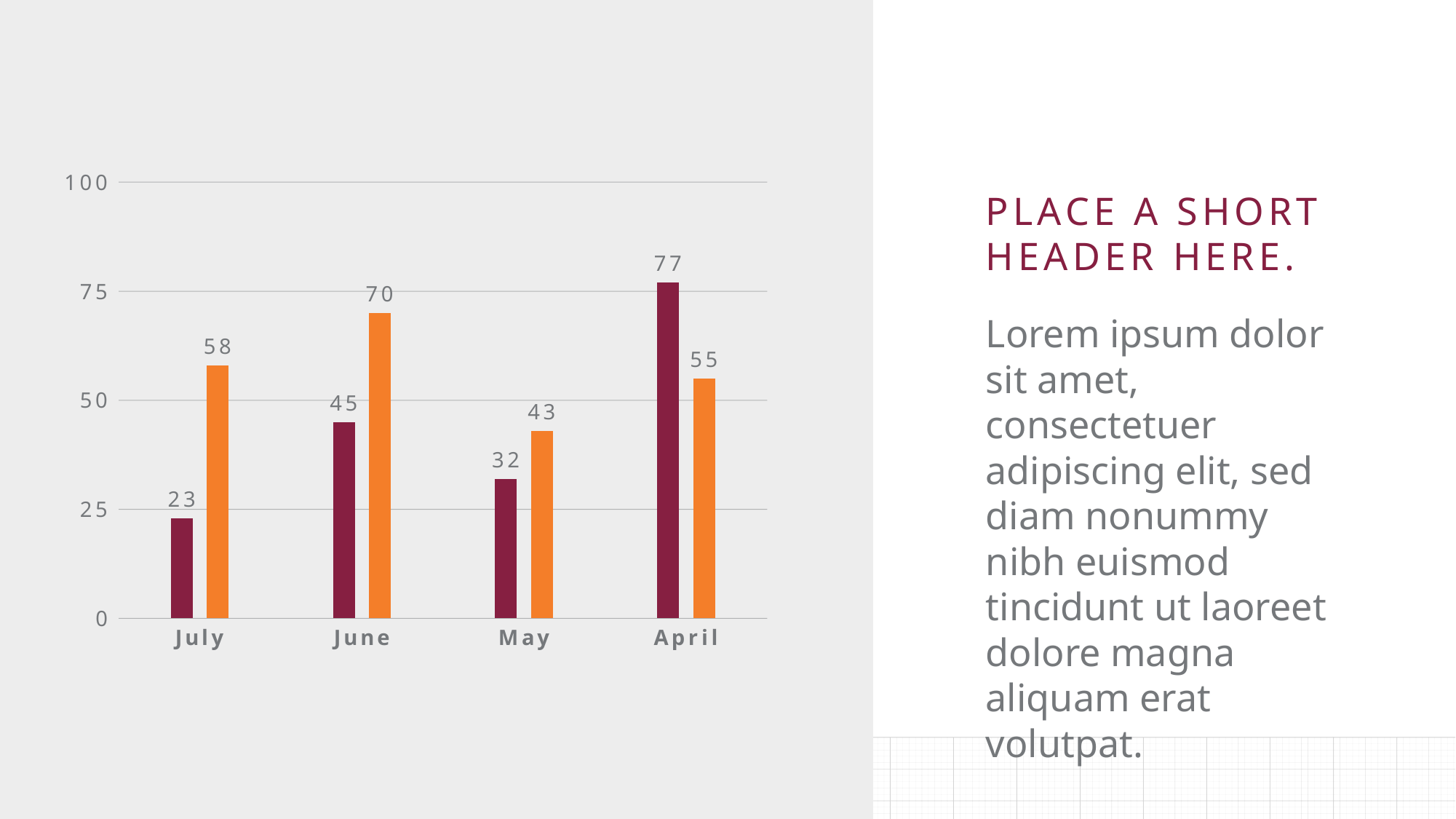
Which category has the highest dark red bar? April What is the value of the dark red bar for May? 32 What is the value of the orange bar for June? 70 What is the value of the dark red bar for July? 23 What kind of chart is shown on the slide? bar chart What is the highest value shown on the y axis? 100 How many categories are shown on the x axis? 4 Which is larger for April, the dark red bar or the orange bar? the dark red bar What is the difference between the orange bar and the dark red bar for July? 35 What is the difference between the dark red bars for April and June? 32 What is the value of the orange bar for April? 55 Which category has the lowest orange bar? May